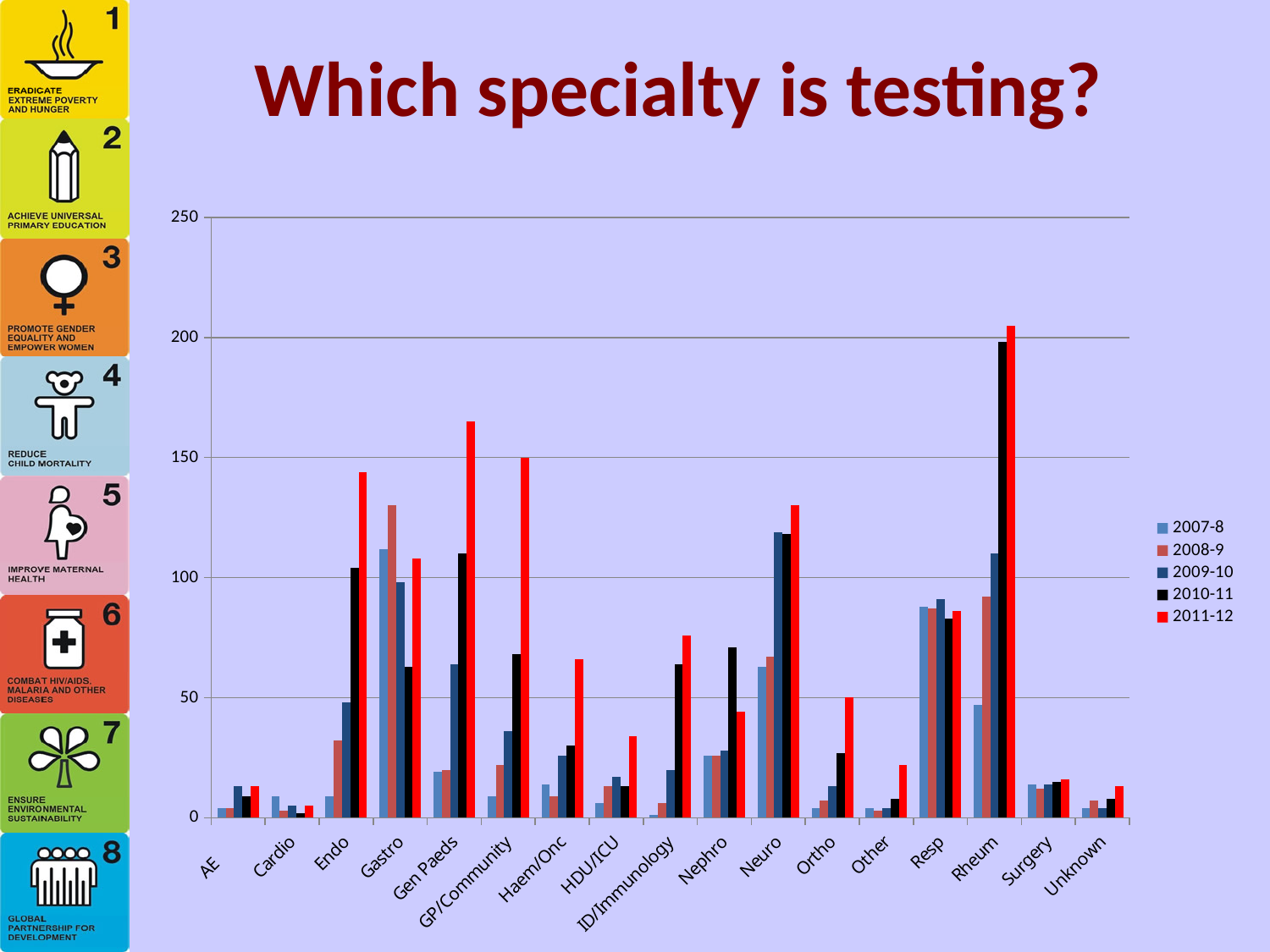
How many specialty categories are shown on the x axis? 17 What is the title of the chart? Which specialty is testing? Is the 2011-12 value for Endo greater or less than 150? less For Gastro, which is larger: the 2008-9 value or the 2011-12 value? 2008-9 How many series does the legend list? 5 Which specialty has the highest value for 2007-8? Gastro Which specialty has the highest value for 2011-12? Rheum What kind of chart is shown on the slide? bar chart Do the values for Rheum rise or fall from 2007-8 to 2011-12? rise Is the 2011-12 value for Rheum greater or less than 200? greater Is the 2011-12 value for Gen Paeds greater or less than 150? greater